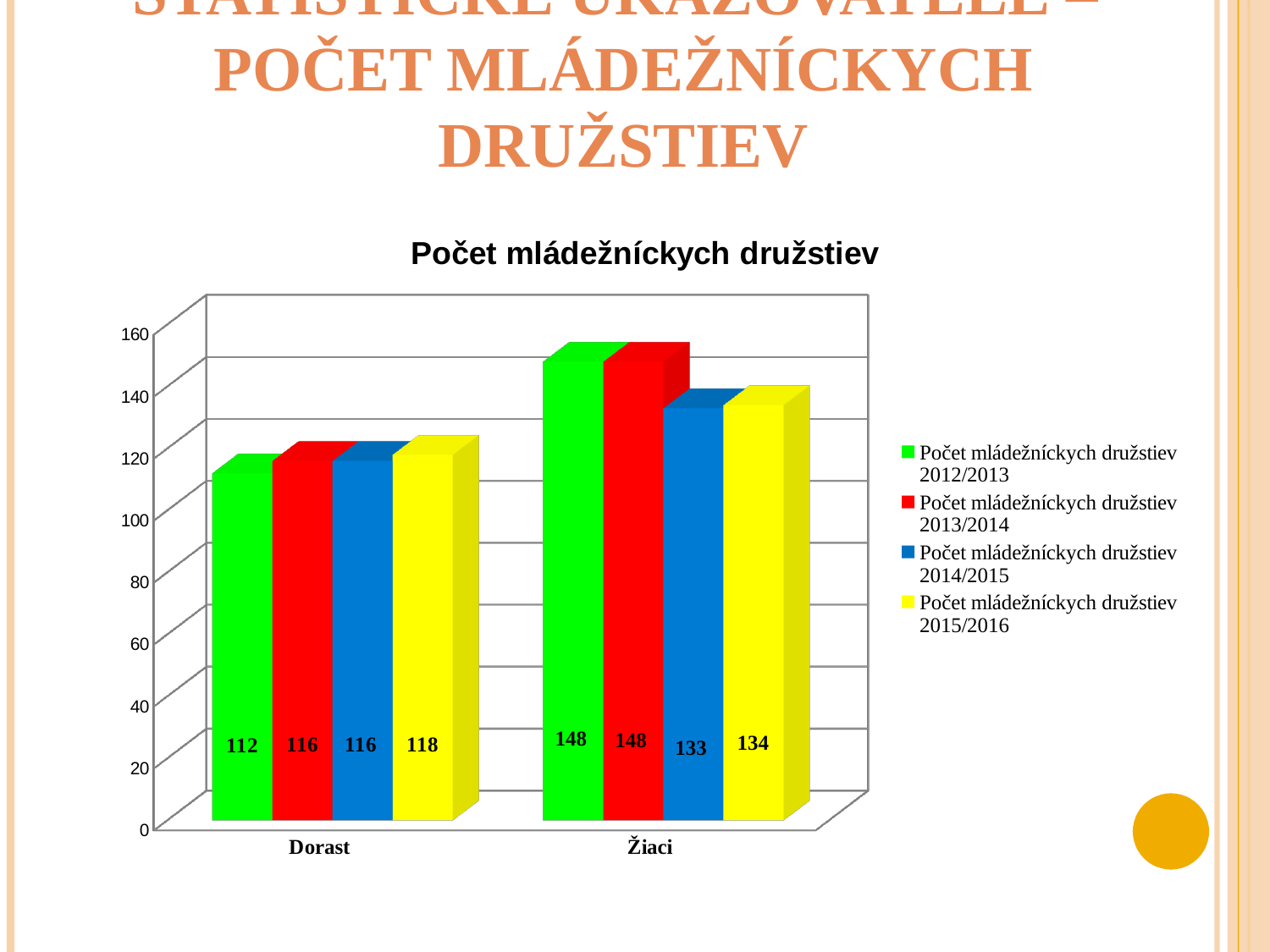
What is the value for Dorast in the 2012/2013 series? 112 What is the value for Dorast in the 2015/2016 series? 118 How many series does the legend list? 4 What is the value for Žiaci in the 2013/2014 series? 148 What is the difference between the Žiaci and Dorast values in the 2015/2016 series? 16 What is the value for Žiaci in the 2014/2015 series? 133 What kind of chart is shown on the slide? Bar chart What is the difference between the Žiaci values for 2013/2014 and 2014/2015? 15 How many categories are shown on the x axis? 2 Which series has the lowest value for Dorast? Počet mládežníckych družstiev 2012/2013 Which is larger: the Dorast value for 2015/2016 or the Dorast value for 2012/2013? Dorast value for 2015/2016 Which category has the highest value in the 2012/2013 series? Žiaci